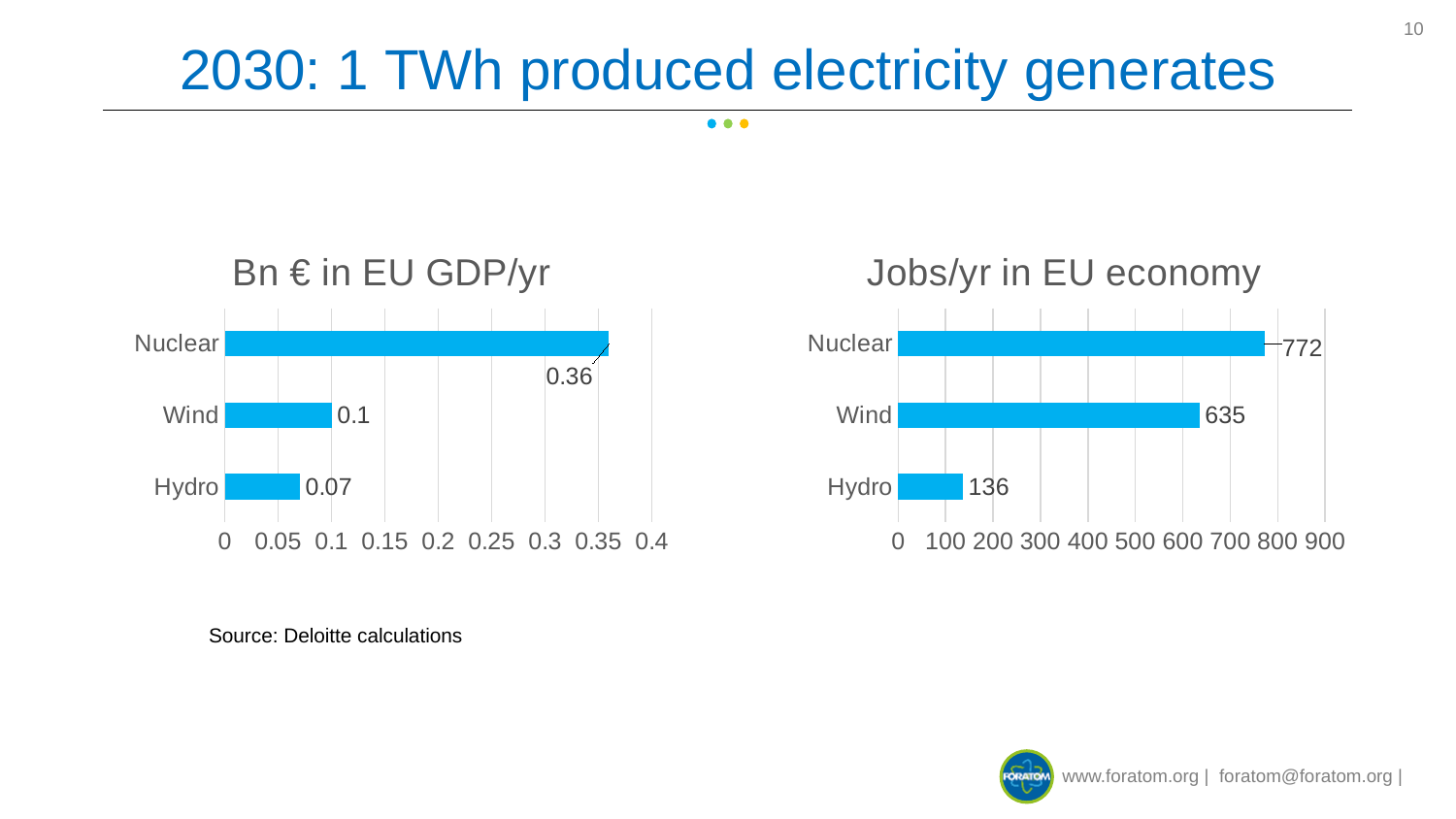
In the 'Bn € in EU GDP/yr' chart, what is the value for Nuclear? 0.36 What kind of chart is the 'Jobs/yr in EU economy' chart? Bar chart What is the title of the chart on the left side of the slide? Bn € in EU GDP/yr In the 'Bn € in EU GDP/yr' chart, what is the difference between the values for Wind and Hydro? 0.03 How many categories are shown in the 'Bn € in EU GDP/yr' chart? 3 In the 'Jobs/yr in EU economy' chart, which category has the highest value? Nuclear In the 'Jobs/yr in EU economy' chart, what is the value for Wind? 635 In the 'Jobs/yr in EU economy' chart, what is the value for Hydro? 136 In the 'Jobs/yr in EU economy' chart, what is the difference between the values for Nuclear and Wind? 137 In the 'Bn € in EU GDP/yr' chart, what is the value for Hydro? 0.07 In the 'Bn € in EU GDP/yr' chart, which category has the lowest value? Hydro In the 'Jobs/yr in EU economy' chart, which is larger, the value for Wind or the value for Hydro? Wind